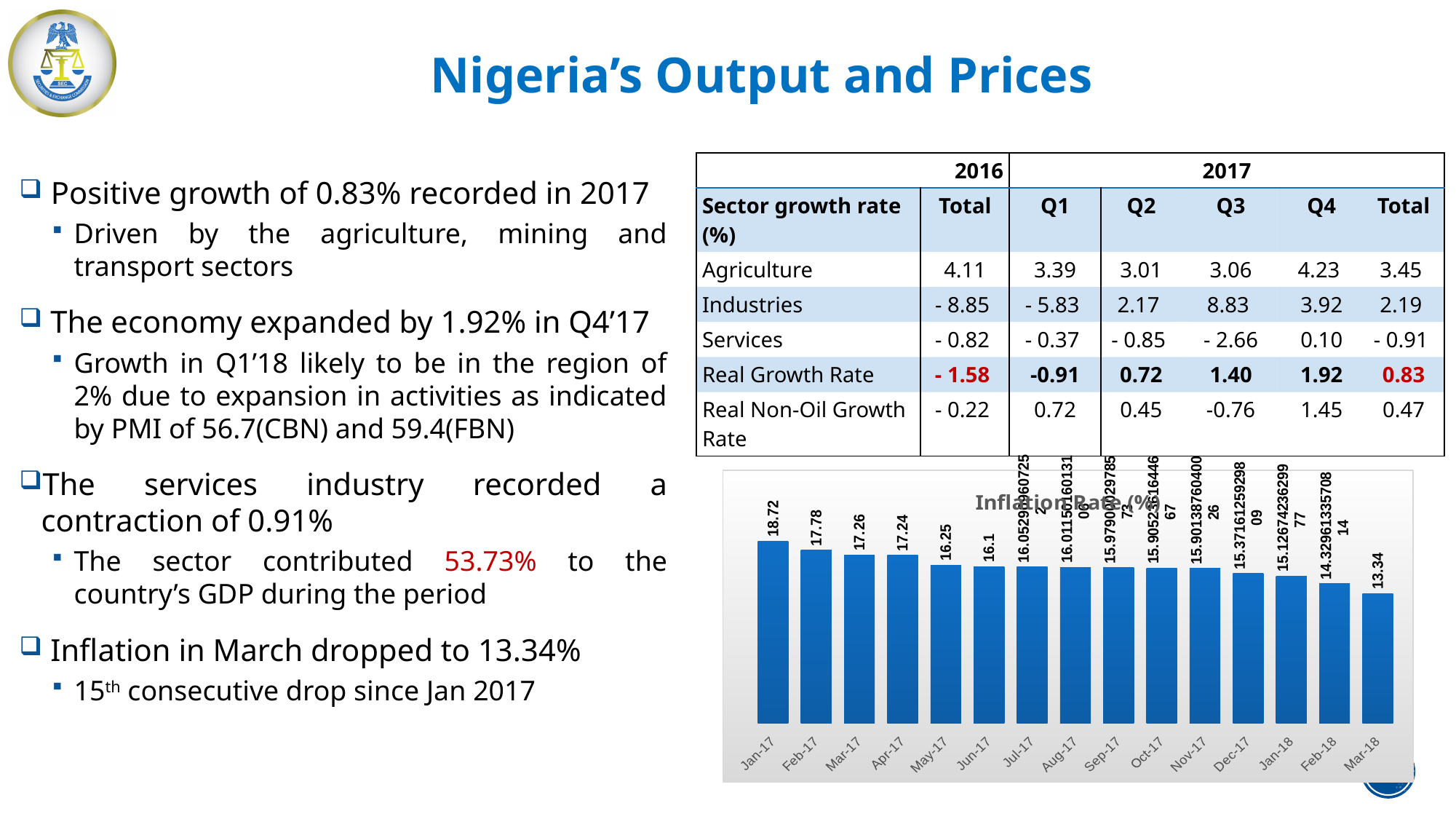
Which month has the lowest inflation rate in the chart? Mar-18 Which is larger, the inflation rate for Feb-17 or for May-17? Feb-17 What kind of chart is used to show the inflation rate? Bar chart What is the inflation rate shown for Jun-17? 16.1 How many months are plotted in the inflation rate chart? 15 What is the difference between the inflation rate in Feb-17 and in Mar-17? 0.52 What is the inflation rate shown for Mar-18? 13.34 What is the inflation rate shown for Jan-17? 18.72 What is the inflation rate shown for May-17? 16.25 What is the difference between the inflation rate in Jan-17 and in Mar-18? 5.38 Which month has the highest inflation rate in the chart? Jan-17 Do the inflation rate values rise or fall from Jan-17 to Mar-18? Fall